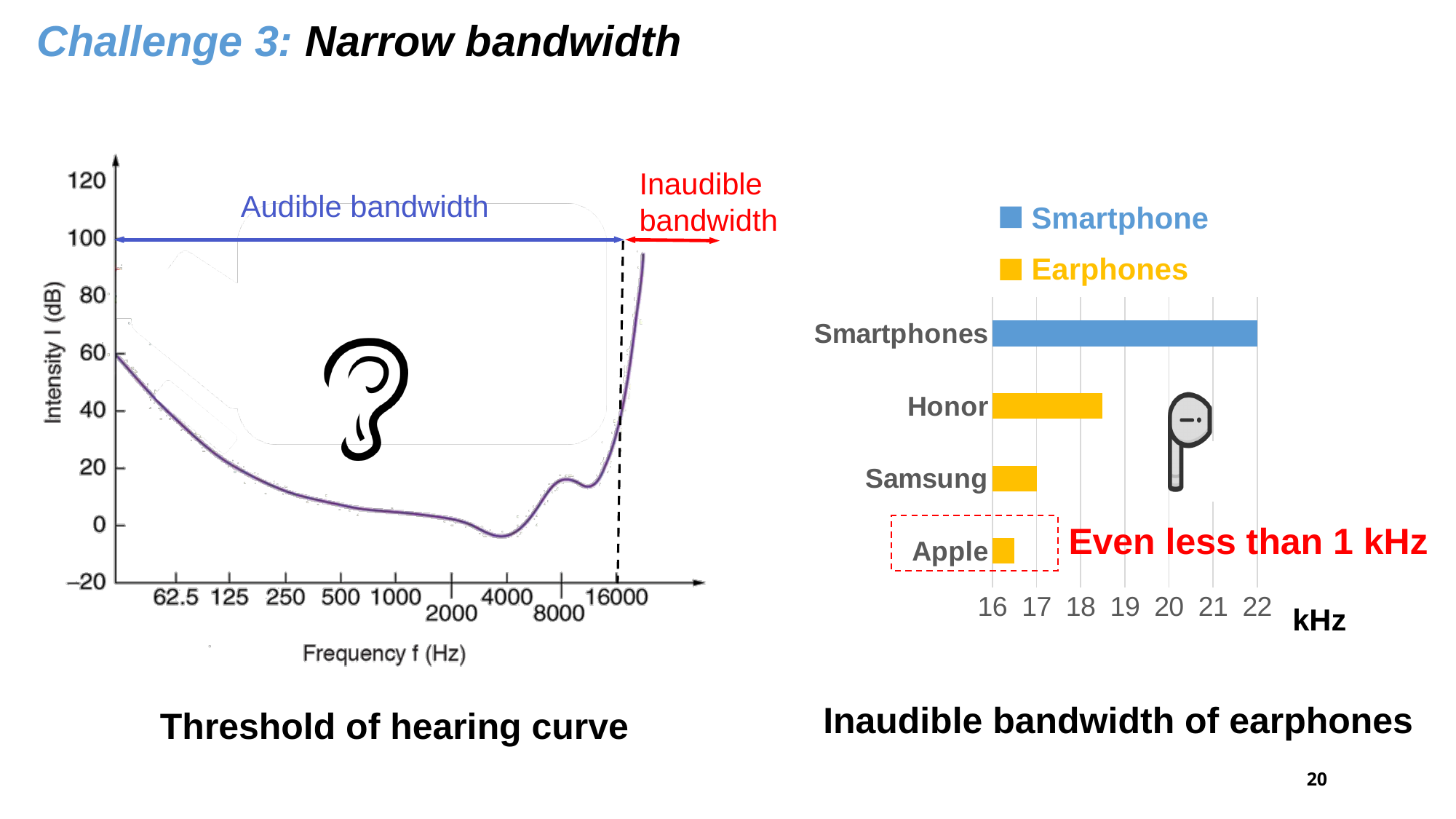
What kind of chart is the 'Inaudible bandwidth of earphones' chart on the right? bar chart In the 'Inaudible bandwidth of earphones' chart, which is larger, the value for Honor or the value for Samsung? Honor In the 'Inaudible bandwidth of earphones' chart, how many series does the legend list? 2 In the 'Inaudible bandwidth of earphones' chart, what unit is shown on the horizontal axis? kHz What kind of chart is the 'Threshold of hearing curve' chart on the left? line chart In the 'Inaudible bandwidth of earphones' chart, is the value for Apple greater or less than 17? less In the 'Inaudible bandwidth of earphones' chart, how many categories are shown? 4 In the 'Inaudible bandwidth of earphones' chart, is the value for Honor greater or less than 18? greater In the 'Inaudible bandwidth of earphones' chart, which category has the lowest value? Apple In the 'Inaudible bandwidth of earphones' chart, which category has the highest value? Smartphones In the 'Threshold of hearing curve' chart, is the intensity at 1000 Hz greater or less than 20 dB? less In the 'Threshold of hearing curve' chart, what is the label of the vertical axis? Intensity I (dB)